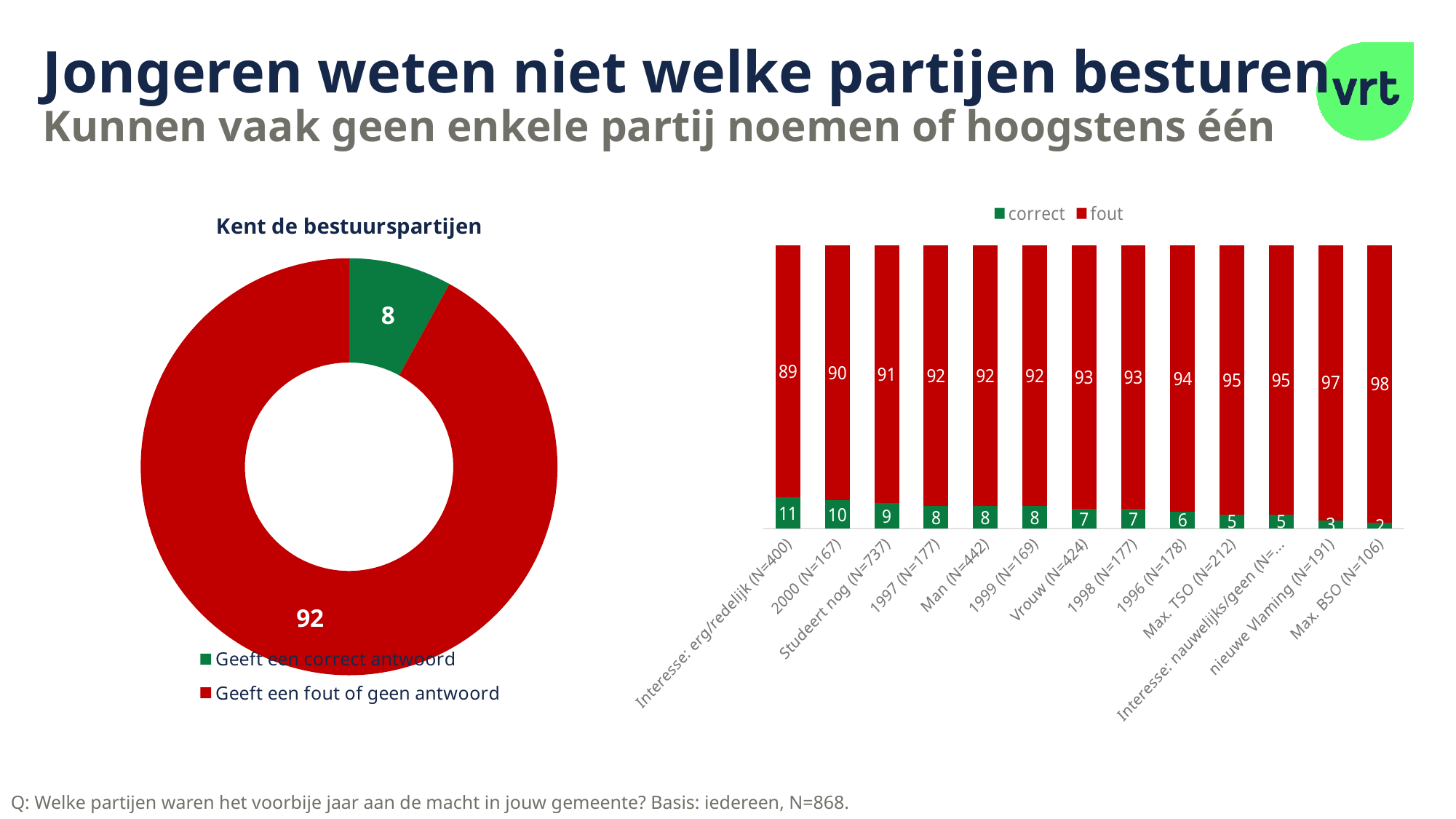
In the stacked bar chart on the right, what is the 'correct' value for 'Man (N=442)'? 8 In the stacked bar chart on the right, what is the total of the 'correct' and 'fout' values for 'Vrouw (N=424)'? 100 In the stacked bar chart on the right, what is the 'fout' value for 'nieuwe Vlaming (N=191)'? 97 In the stacked bar chart on the right, which has a larger 'correct' value: '2000 (N=167)' or '1996 (N=178)'? 2000 (N=167) What kind of chart is the chart on the left titled 'Kent de bestuurspartijen'? Donut (pie) chart In the stacked bar chart on the right, what is the difference between the 'fout' values for 'Max. BSO (N=106)' and 'Interesse: erg/redelijk (N=400)'? 9 In the donut chart 'Kent de bestuurspartijen', what value is shown for 'Geeft een correct antwoord'? 8 In the stacked bar chart on the right, which category has the lowest 'correct' value? Max. BSO (N=106) In the stacked bar chart on the right, which category has the highest 'correct' value? Interesse: erg/redelijk (N=400) How many series does the legend of the stacked bar chart on the right list? 2 In the donut chart 'Kent de bestuurspartijen', what value is shown for 'Geeft een fout of geen antwoord'? 92 How many categories are shown on the x axis of the stacked bar chart on the right? 13